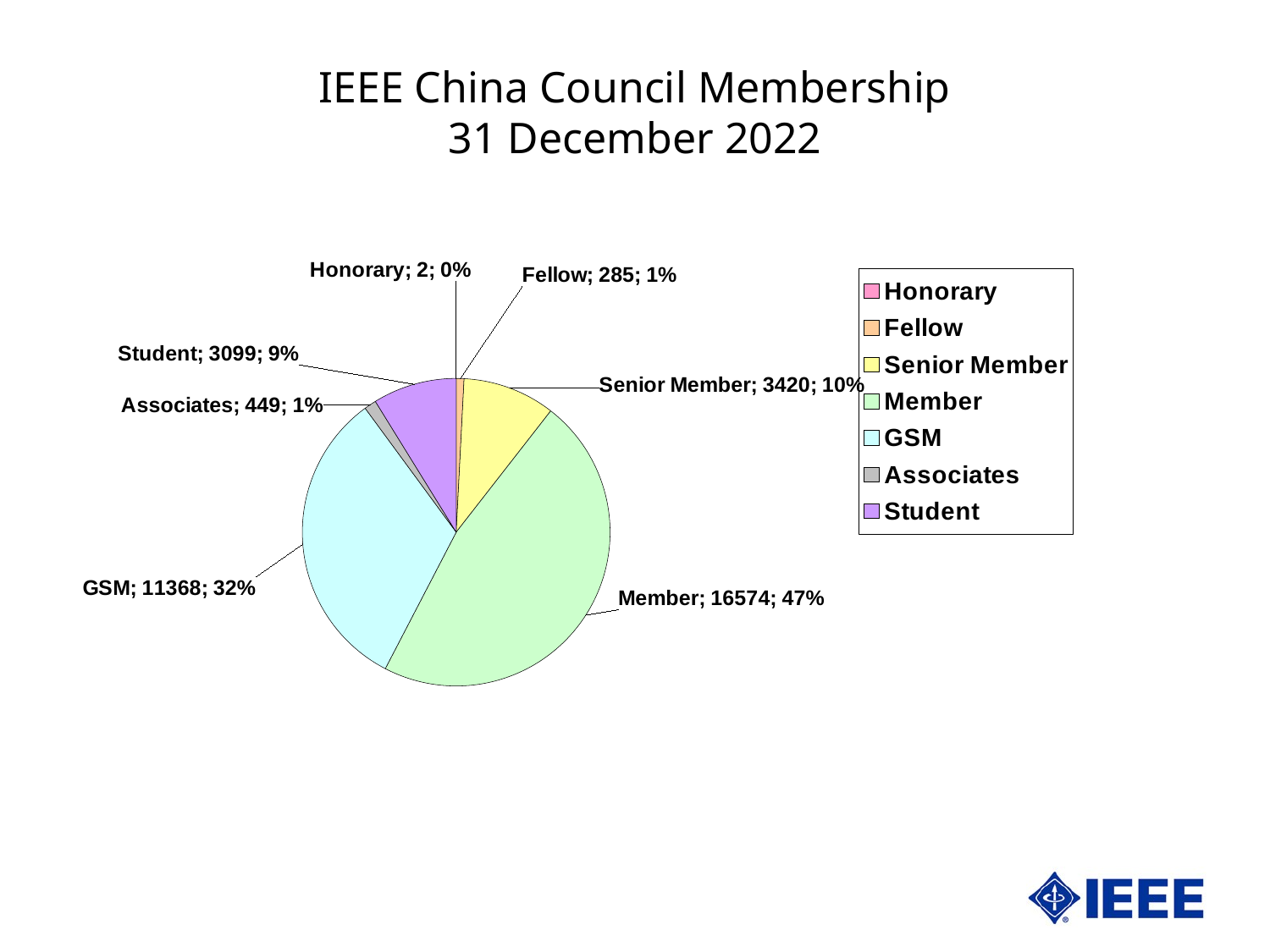
Which category has the largest slice? Member What is the value for Senior Member? 3420 Which category has the smallest slice? Honorary What is the value for GSM? 11368 What is the difference between the Member and GSM values? 5206 Which is larger, Student or Associates? Student What type of chart is shown on the slide? pie chart How many membership categories does the pie chart show? 7 What share of the pie does GSM represent? 32% What is the value for Fellow? 285 What is the value for Member? 16574 What share of the pie does Student represent? 9%